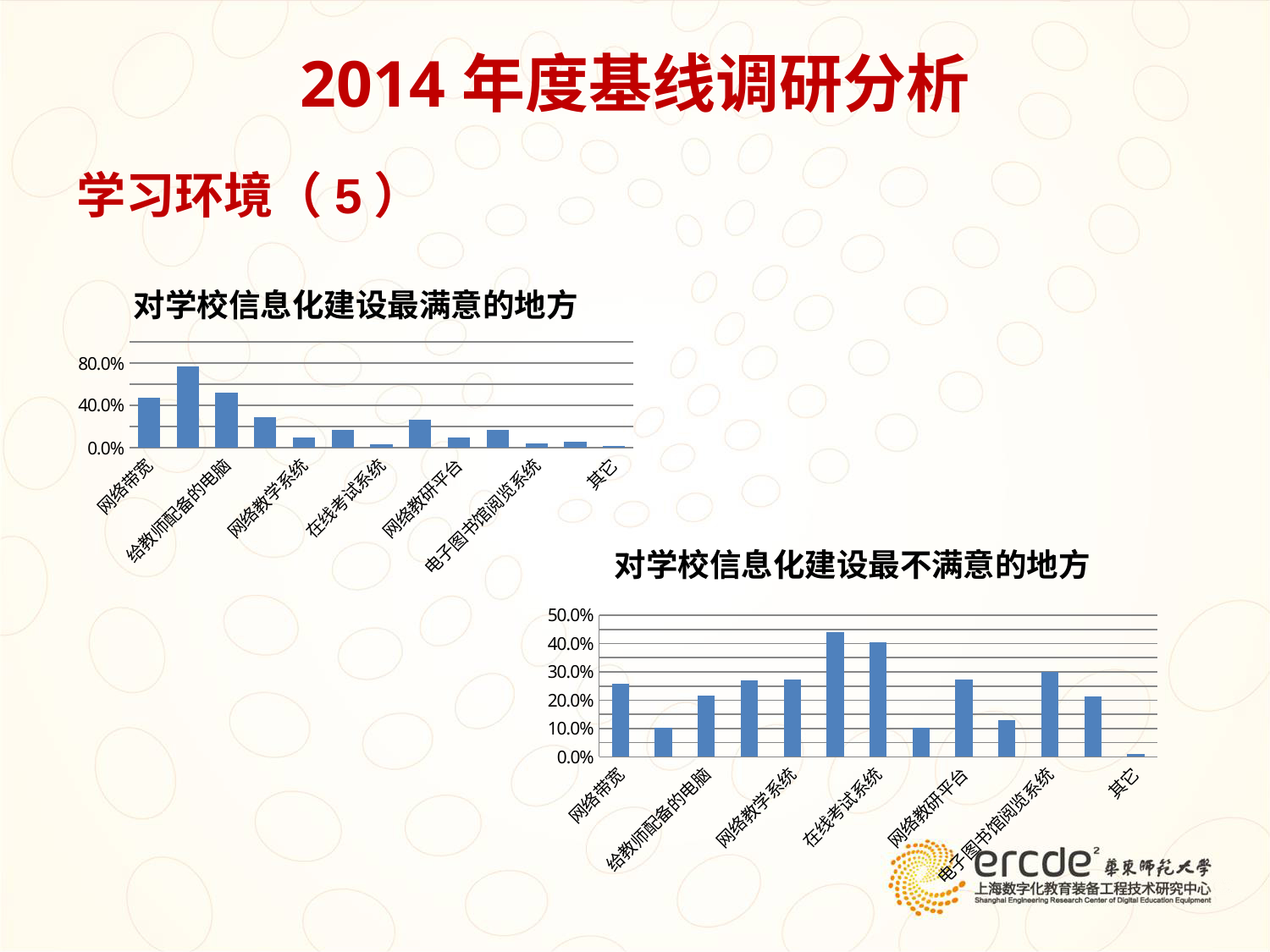
In the chart titled 对学校信息化建设最不满意的地方, is the value for 网络带宽 greater or less than 20.0%? greater In the chart titled 对学校信息化建设最不满意的地方, is the value for 其它 greater or less than 10.0%? less In the chart titled 对学校信息化建设最满意的地方, is the value for 网络带宽 greater or less than 40.0%? greater In the chart titled 对学校信息化建设最不满意的地方, which is larger, the value for 电子图书馆阅览系统 or the value for 给教师配备的电脑? 电子图书馆阅览系统 How many bars are plotted in the chart titled 对学校信息化建设最不满意的地方? 13 In the chart titled 对学校信息化建设最不满意的地方, which labelled category has the lowest value? 其它 What is the highest tick label on the vertical axis of the chart titled 对学校信息化建设最满意的地方? 80.0% What kind of chart is the chart titled 对学校信息化建设最满意的地方? bar chart In the chart titled 对学校信息化建设最不满意的地方, which is larger, the value for 在线考试系统 or the value for 其它? 在线考试系统 How many bars are plotted in the chart titled 对学校信息化建设最满意的地方? 13